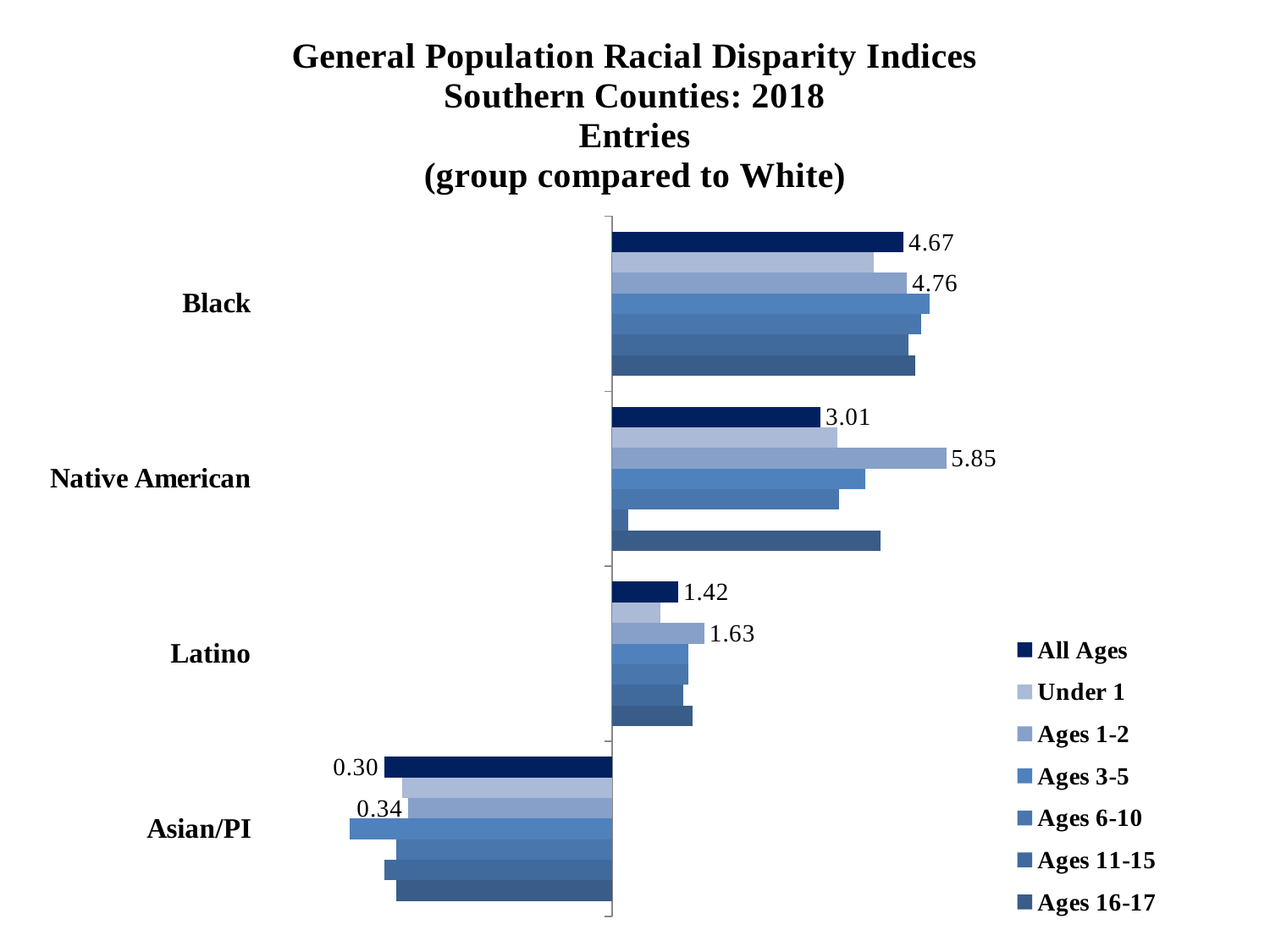
How many series does the legend list? 7 What is the Ages 1-2 disparity index for Native American? 5.85 Which group has the highest All Ages disparity index? Black What is the last series listed in the legend? Ages 16-17 What is the All Ages disparity index for Black? 4.67 What is the difference between the Ages 1-2 and All Ages indices for Native American? 2.84 How many racial groups are shown on the chart? 4 What is the All Ages disparity index for Asian/PI? 0.30 Which group has the lowest All Ages disparity index? Asian/PI What kind of chart is shown on the slide? Bar chart Which is larger: the Ages 1-2 index for Native American or the Ages 1-2 index for Black? Native American What is the All Ages disparity index for Latino? 1.42